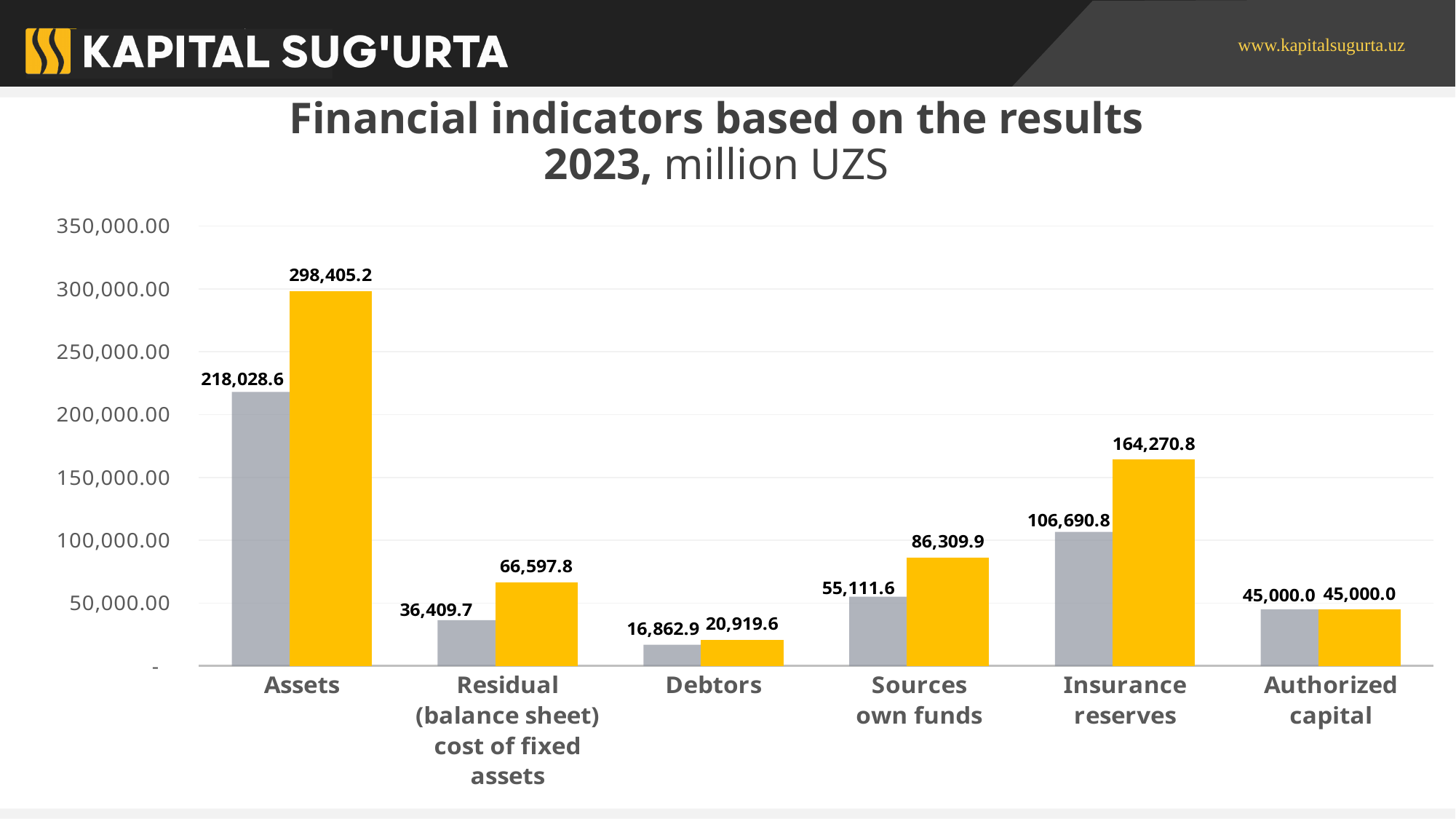
What kind of chart is shown on the slide? bar chart What is the value of the yellow bar for Assets? 298,405.2 Which category has the highest yellow bar? Assets What is the difference between the yellow and grey bars for Insurance reserves? 57,580.0 Which is larger: the yellow bar for Sources own funds or the grey bar for Insurance reserves? the grey bar for Insurance reserves What is the value of the grey bar for Debtors? 16,862.9 What is the value of the yellow bar for Sources own funds? 86,309.9 What is the value of the grey bar for Insurance reserves? 106,690.8 What unit is stated in the chart title? million UZS How many categories are shown on the x axis? 6 What is the difference between the yellow and grey bars for Assets? 80,376.6 Which category has the lowest grey bar? Debtors